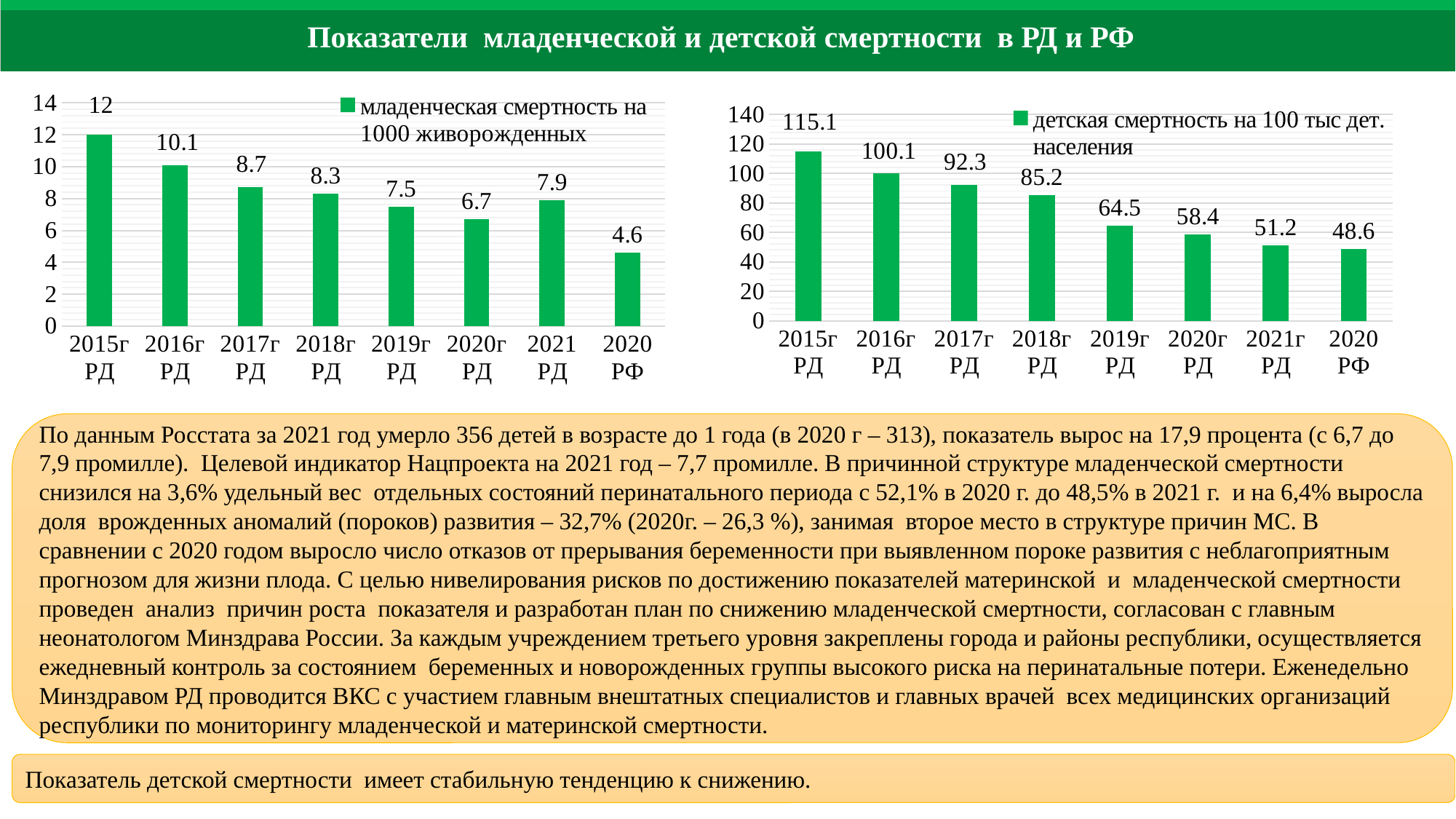
On the right chart (детская смертность на 100 тыс дет. населения), what is the difference between the values for 2015г РД and 2016г РД? 15 On the right chart (детская смертность на 100 тыс дет. населения), do the values for the РД categories rise or fall from 2015г to 2021г? fall On the right chart (детская смертность на 100 тыс дет. населения), which category has the highest value? 2015г РД On the left chart (младенческая смертность на 1000 живорожденных), which category has the lowest value? 2020 РФ On the right chart (детская смертность на 100 тыс дет. населения), which is larger: the value for 2019г РД or 2020г РД? 2019г РД What type of chart is the left chart on the slide? bar chart On the right chart (детская смертность на 100 тыс дет. населения), what is the value for 2018г РД? 85.2 On the left chart (младенческая смертность на 1000 живорожденных), how many bars are plotted? 8 On the left chart (младенческая смертность на 1000 живорожденных), what is the value for 2021 РД? 7.9 On the left chart (младенческая смертность на 1000 живорожденных), what is the difference between the values for 2020г РД and 2021 РД? 1.2 On the left chart (младенческая смертность на 1000 живорожденных), what is the value for 2015г РД? 12 On the right chart (детская смертность на 100 тыс дет. населения), what is the value for 2020 РФ? 48.6